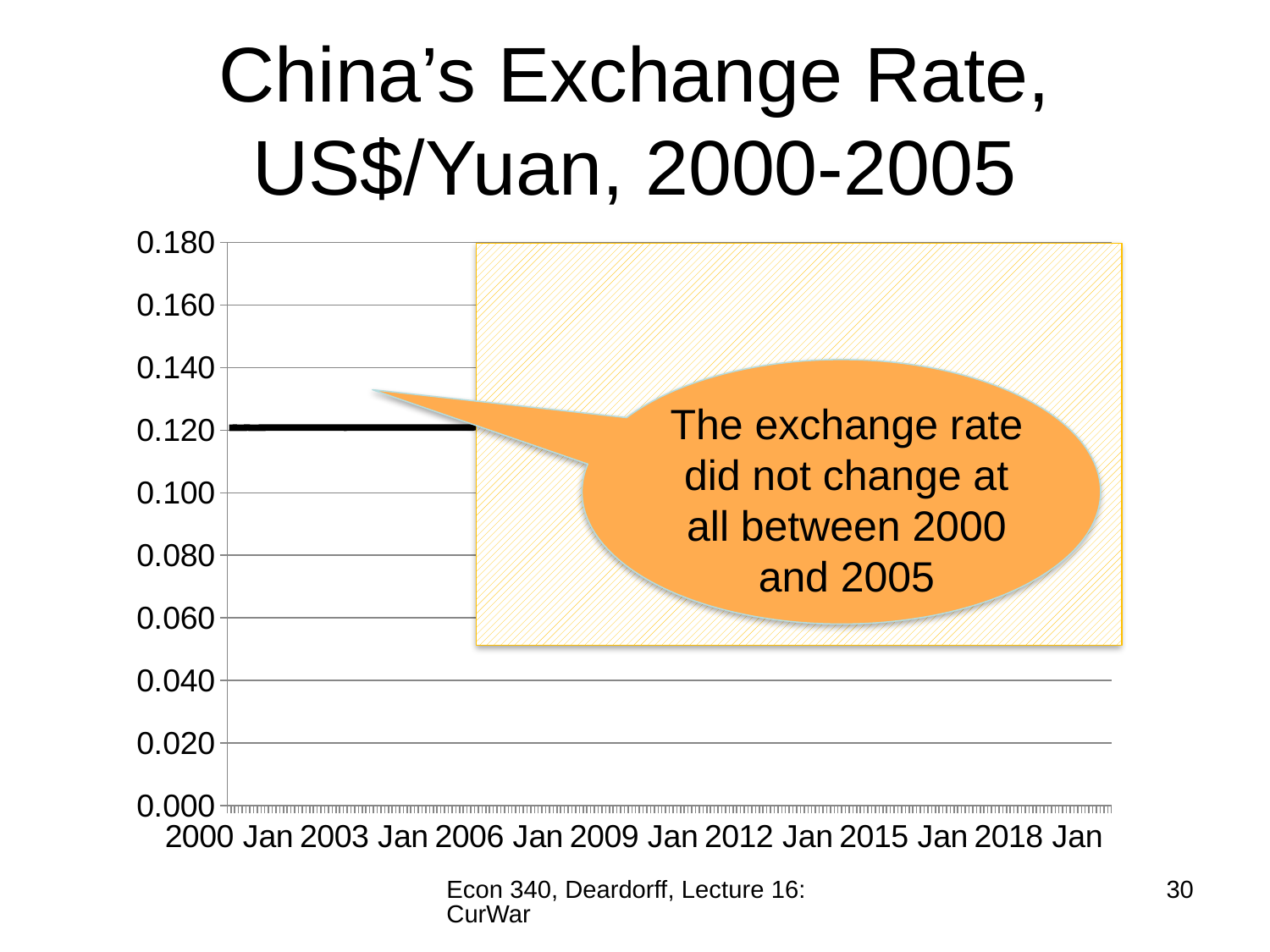
What is the first year label on the horizontal axis? 2000 Jan How many year labels are shown along the horizontal axis? 7 Is the plotted exchange rate in 2001 greater or less than 0.140? less Does the plotted exchange rate rise, fall, or stay flat between 2000 and 2005? stays flat What is the highest value shown on the vertical axis? 0.180 Is the plotted exchange rate in 2004 greater or less than 0.160? less Is the plotted exchange rate in 2003 greater or less than 0.100? greater What is the title of the chart? China's Exchange Rate, US$/Yuan, 2000-2005 What kind of chart is shown on the slide? line chart What is the last year label on the horizontal axis? 2018 Jan